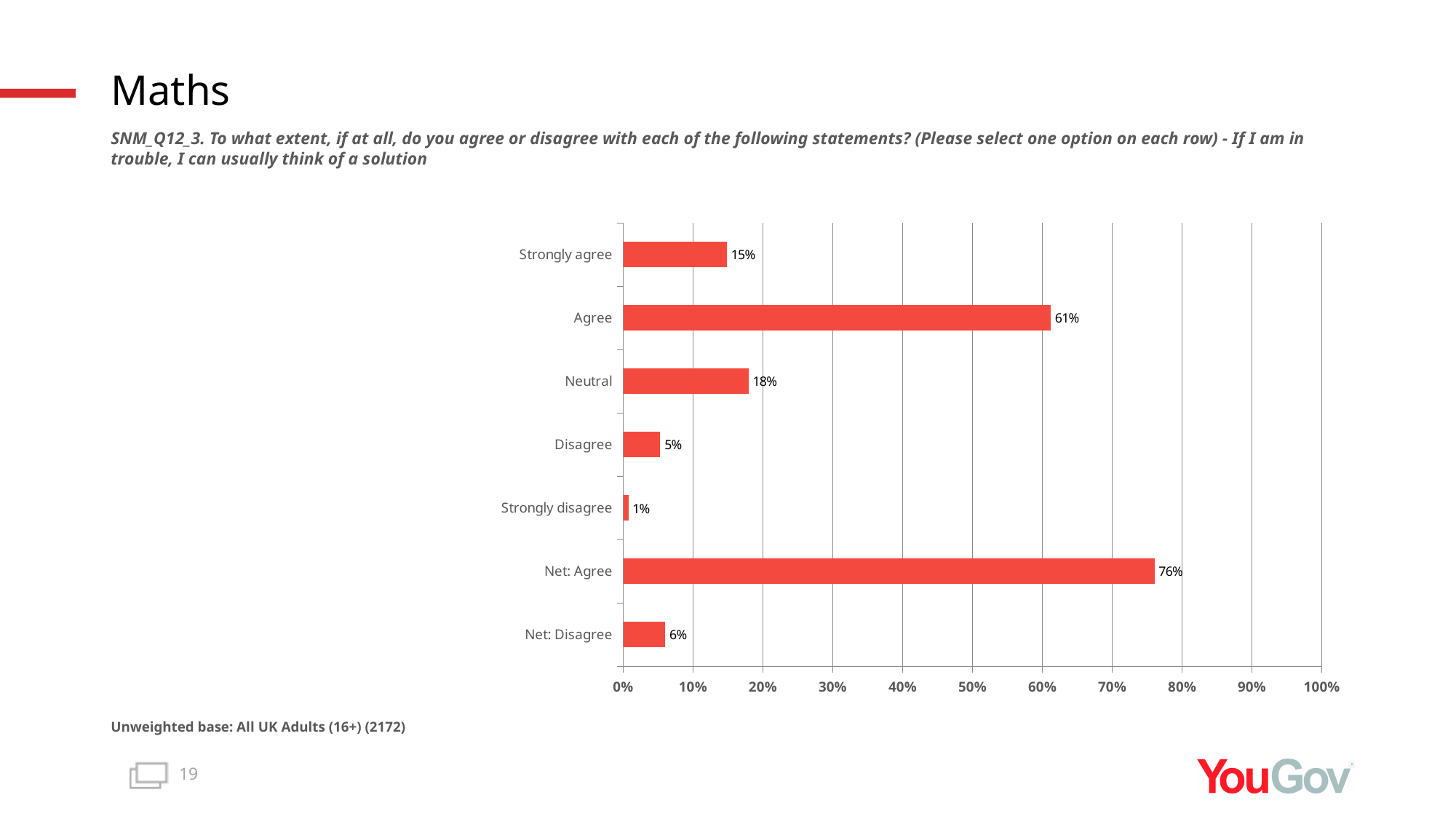
Which category has the highest value? Net: Agree What is the difference between 'Agree' and 'Strongly agree'? 46% What is the value shown for 'Strongly disagree'? 1% What is the difference between 'Net: Agree' and 'Net: Disagree'? 70% Is the value for 'Agree' greater or less than 50%? greater What is the value for 'Net: Agree'? 76% Which is larger, 'Neutral' or 'Strongly agree'? Neutral Which category has the lowest value? Strongly disagree What kind of chart is shown on the slide? Bar chart What percentage of respondents selected 'Agree'? 61% What is the unweighted base stated below the chart? All UK Adults (16+) (2172) How many categories are shown on the chart? 7